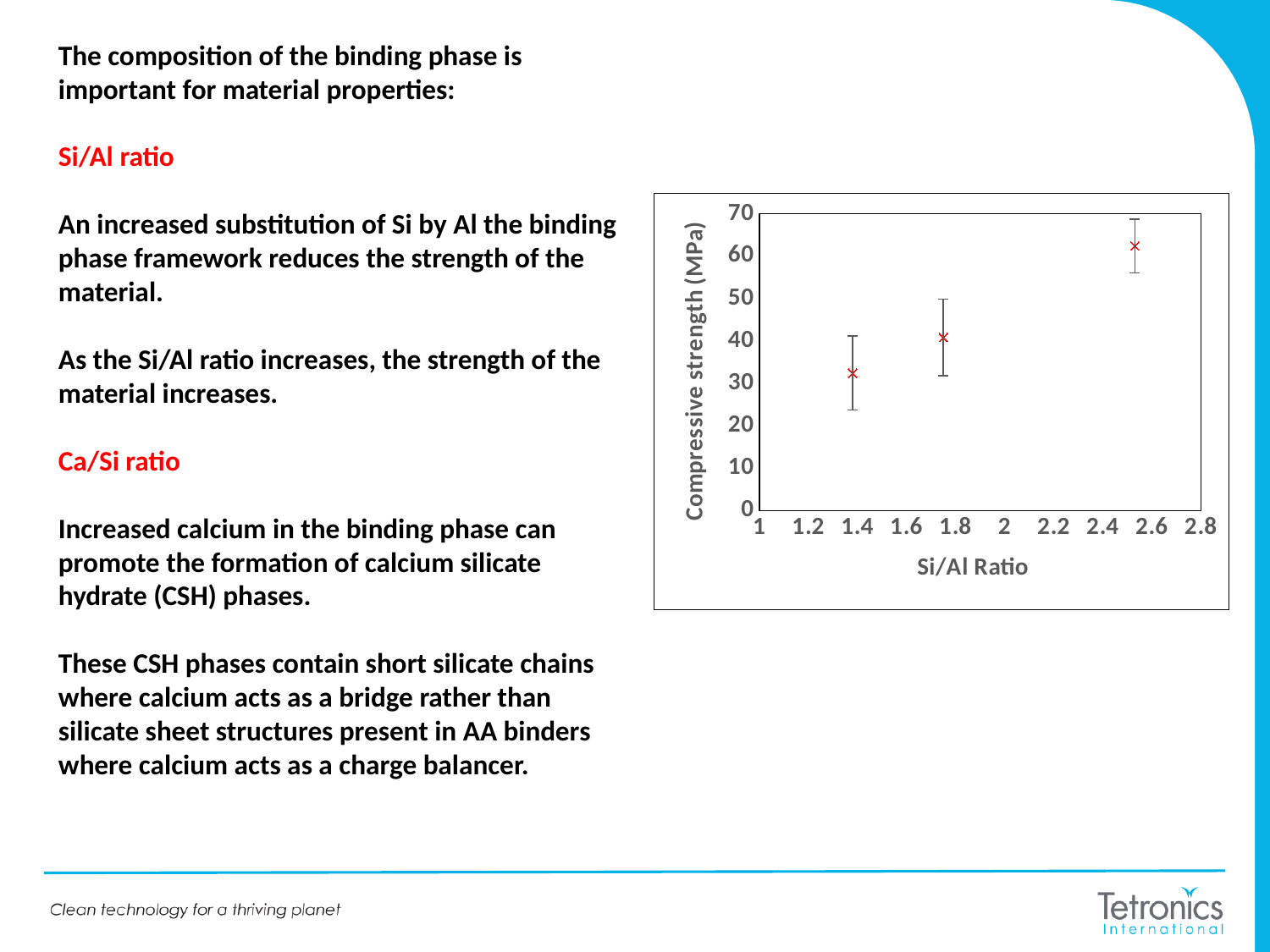
Is the compressive strength of the data point with the highest Si/Al ratio greater or less than 50 MPa? greater Is the compressive strength of the data point with the lowest Si/Al ratio greater or less than 50 MPa? less Is the compressive strength of the middle data point (Si/Al ratio between 1.6 and 1.8) greater or less than 50 MPa? less Does compressive strength rise or fall as the Si/Al ratio increases along the x axis? rise What is the label of the x axis of the chart? Si/Al Ratio What is the maximum value shown on the y axis of the chart? 70 What kind of chart is shown on the slide? scatter chart How many data points are plotted on the chart? 3 What is the label of the y axis of the chart? Compressive strength (MPa) Which data point has the highest compressive strength: the one with the lowest Si/Al ratio or the one with the highest Si/Al ratio? the one with the highest Si/Al ratio